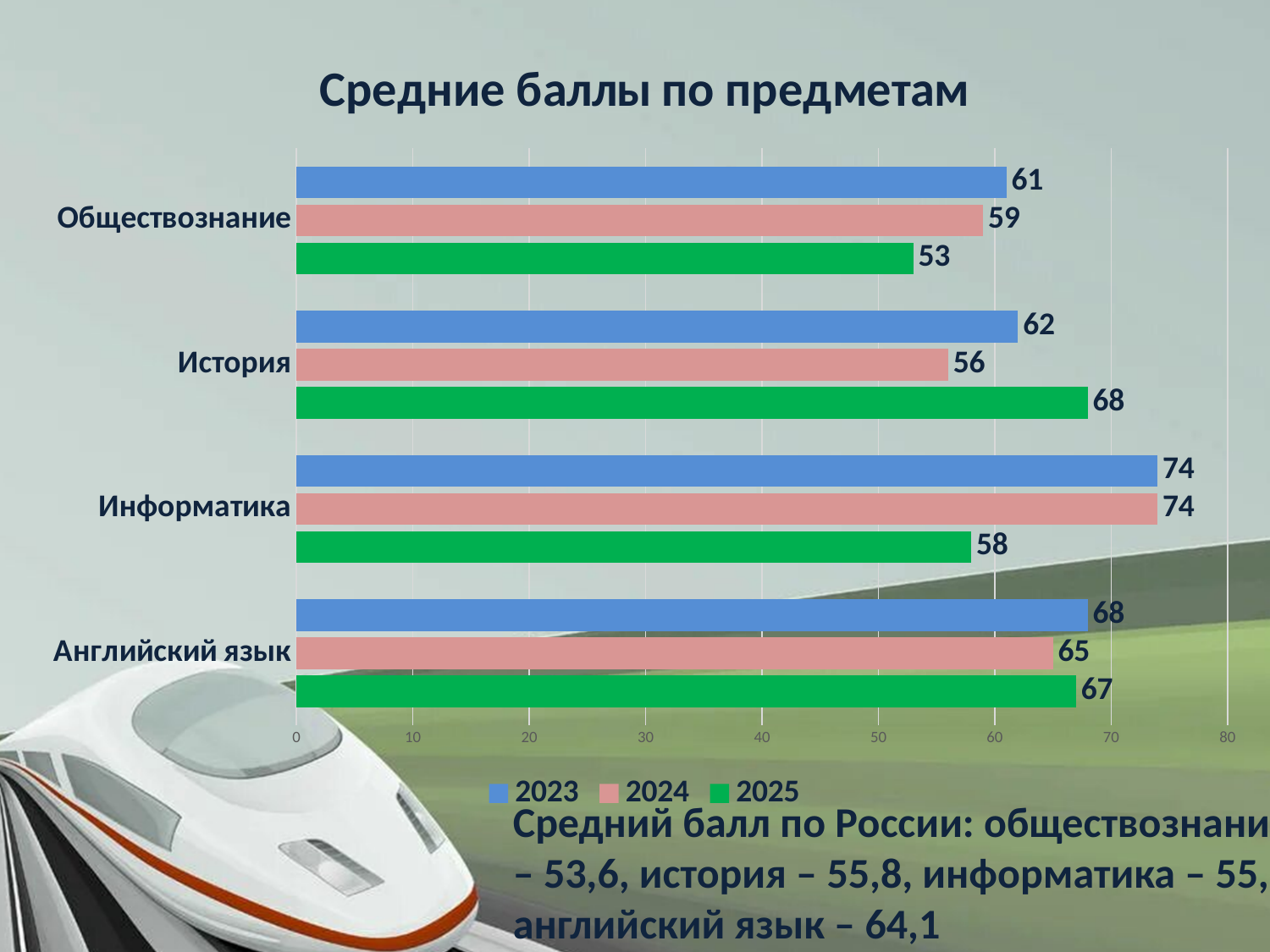
How many series does the legend list? 3 What is the 2023 value for Обществознание? 61 Which is larger for История: the 2024 value or the 2025 value? 2025 What is the 2024 value for Английский язык? 65 Which colour represents the 2025 series in the legend? green What is the title of the chart? Средние баллы по предметам What is the 2025 value for История? 68 How many subjects are shown on the chart? 4 What kind of chart is shown on the slide? bar chart Which subject has the highest 2023 value? Информатика Which subject has the lowest 2025 value? Обществознание What is the difference between the 2023 and 2025 values for Информатика? 16